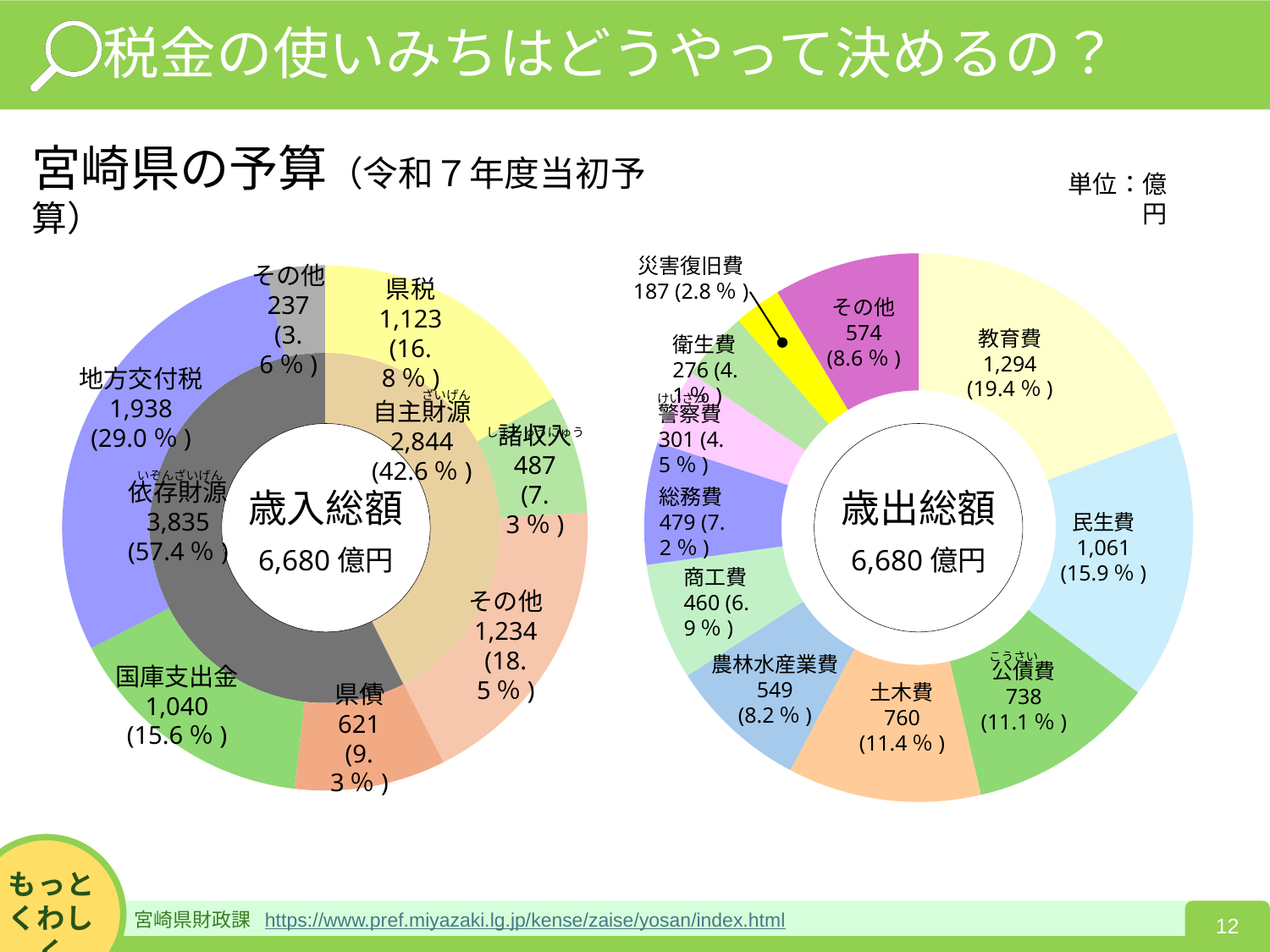
In the 歳入総額 chart on the left, what percentage share is shown for 自主財源? 42.6% In the 歳出総額 chart on the right, which is larger, 総務費 or 商工費? 総務費 In the 歳出総額 chart on the right, which category has the smallest value? 災害復旧費 In the 歳出総額 chart on the right, what percentage share is shown for 民生費? 15.9% In the 歳出総額 chart on the right, what is the difference between 土木費 and 公債費? 22 What total amount is shown in the centre of the 歳出総額 chart on the right? 6,680 億円 In the 歳入総額 chart on the left, which outer-ring category has the largest value? 地方交付税 In the 歳出総額 chart on the right, what is the value for 教育費? 1,294 In the 歳入総額 chart on the left, what is the value for 地方交付税? 1,938 In the 歳入総額 chart on the left, which is larger, 県税 or 国庫支出金? 県税 In the 歳出総額 chart on the right, which category has the largest value? 教育費 What kind of chart is used for 歳入総額 on the left? Donut (pie) chart